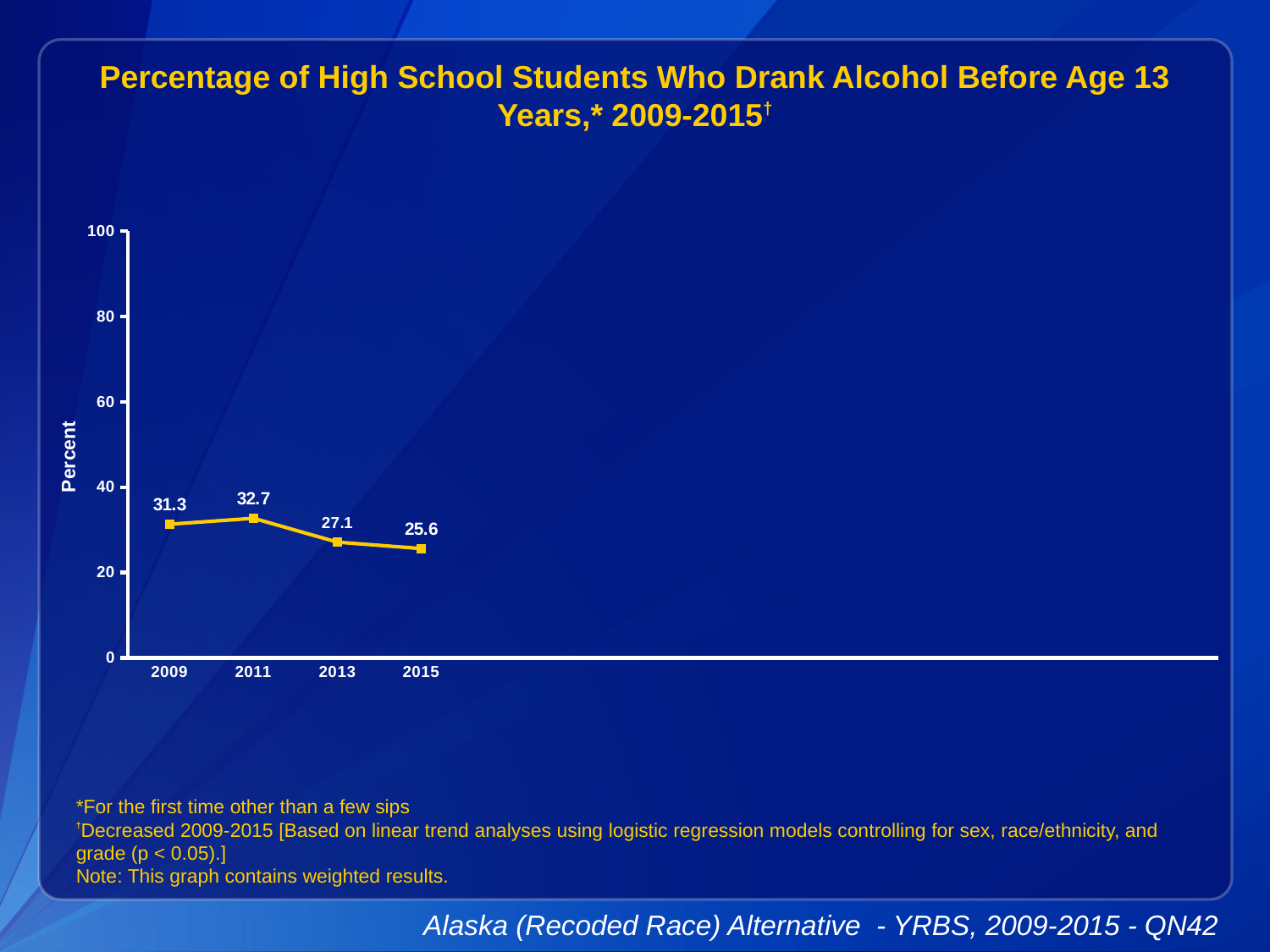
What is the value for 2013? 27.1 Which year has the highest value? 2011 Which is larger, the value for 2009 or the value for 2013? 2009 What is the value for 2009? 31.3 What is the difference between the values for 2011 and 2015? 7.1 What is the value for 2011? 32.7 What kind of chart is shown on the slide? line chart Is the value for 2015 greater or less than 40? less Which year has the lowest value? 2015 What is the label on the y axis? Percent How many data points are plotted on the chart? 4 What is the value for 2015? 25.6